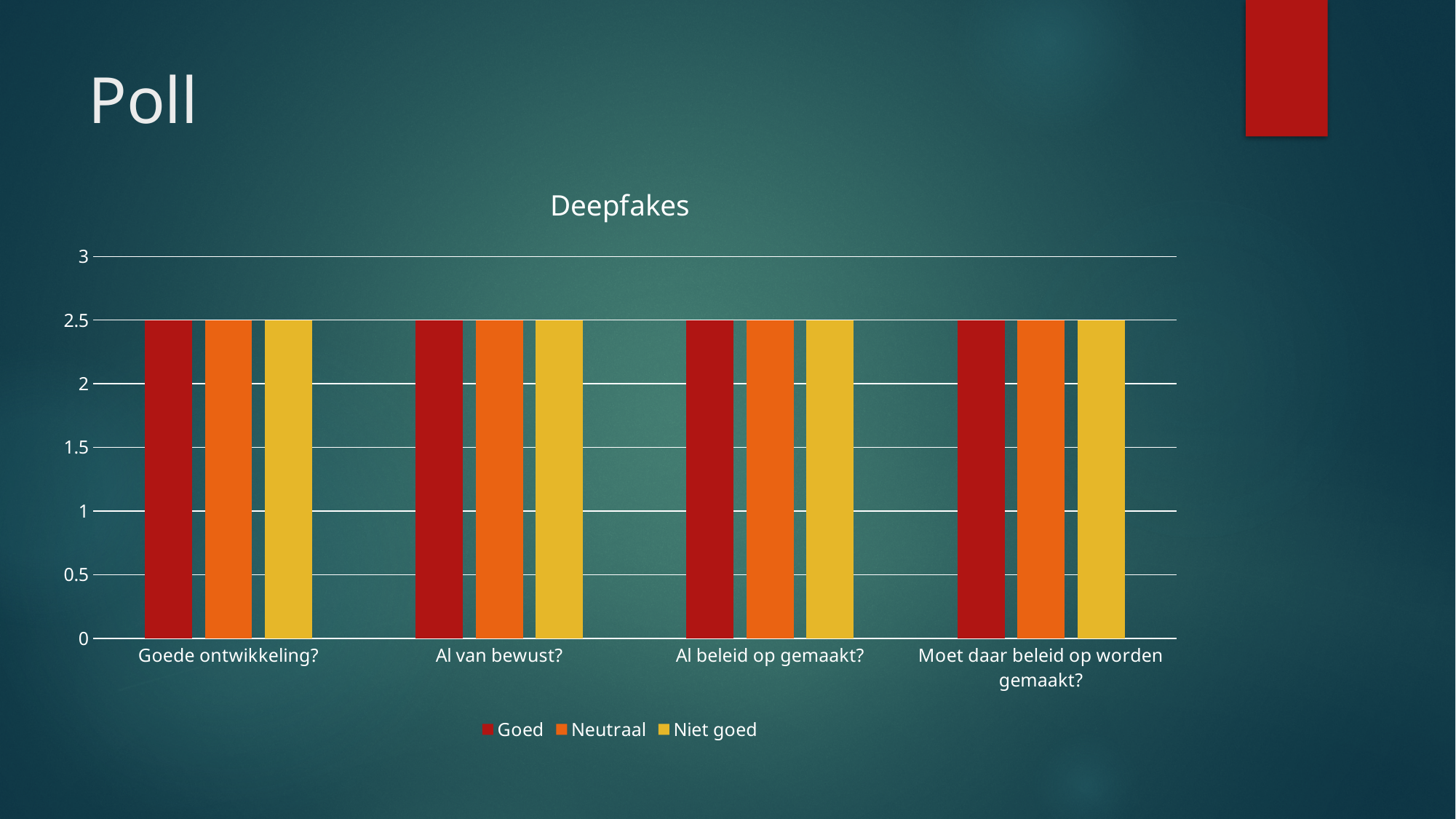
Is the value of the Neutraal series for "Moet daar beleid op worden gemaakt?" greater or less than 3? less Is the value of the Niet goed series for "Goede ontwikkeling?" greater or less than 2? greater What is the value of the Neutraal series for "Al van bewust?"? 2.5 Which series is shown in dark red in the legend? Goed What is the highest value shown on the y axis? 3 What is the title of the chart? Deepfakes What is the value of the Goed series for "Goede ontwikkeling?"? 2.5 What is the value of the Niet goed series for "Al beleid op gemaakt?"? 2.5 What kind of chart is shown on the slide? bar chart What is the value of the Goed series for "Moet daar beleid op worden gemaakt?"? 2.5 How many series does the legend list? 3 How many categories are shown on the x axis of the chart? 4